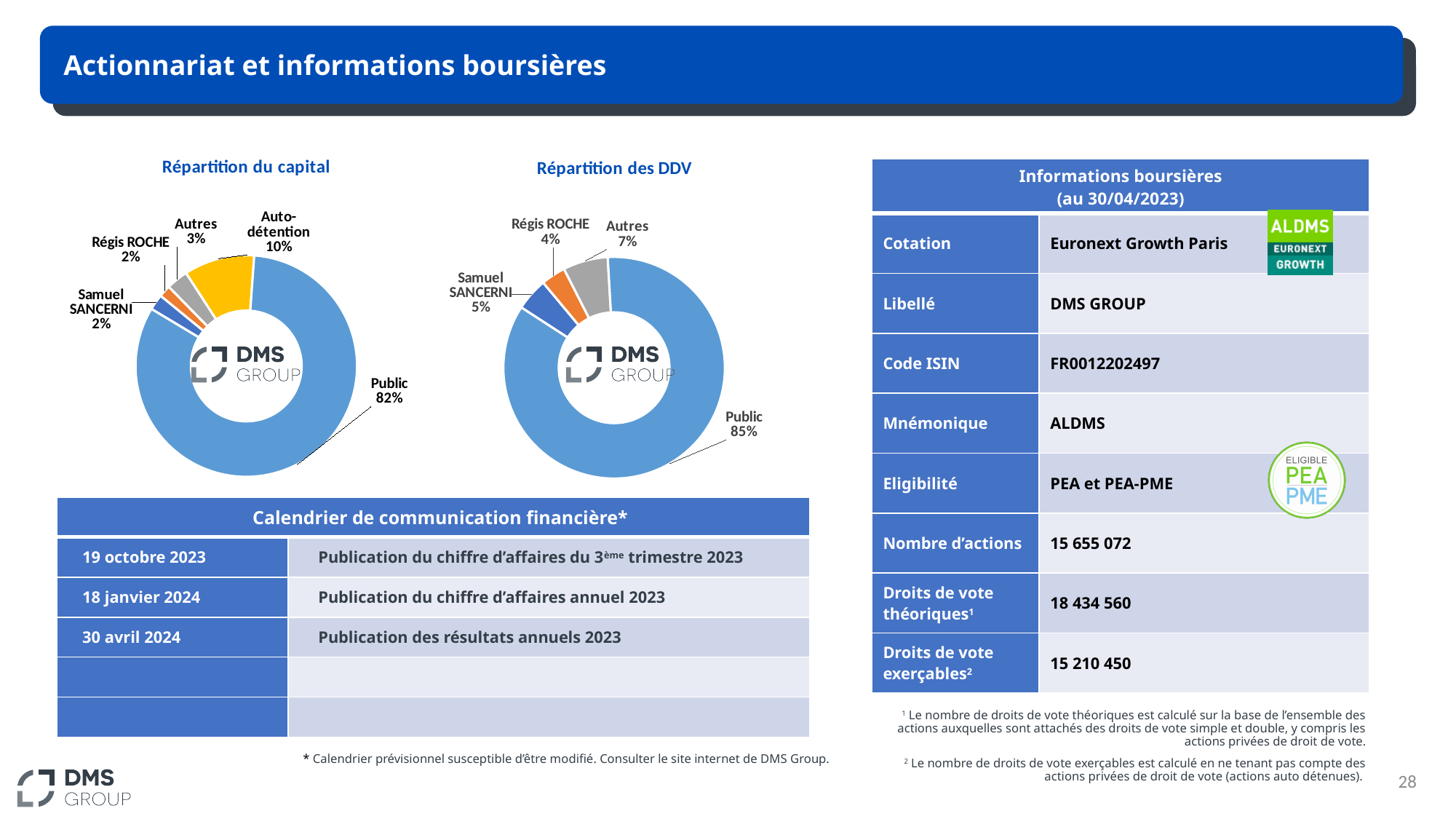
In the 'Répartition des DDV' chart, which category has the smallest share? Régis ROCHE In the 'Répartition du capital' chart, which category has the largest share? Public In the 'Répartition des DDV' chart, what share does Public hold? 85% In the 'Répartition du capital' chart, what share is Auto-détention? 10% What type of chart is 'Répartition des DDV'? Pie (donut) chart How many categories are shown in the 'Répartition du capital' chart? 5 In the 'Répartition des DDV' chart, what is the difference between the Public share and the Autres share? 78% In the 'Répartition des DDV' chart, what share is Autres? 7% In the 'Répartition des DDV' chart, what share does Samuel SANCERNI hold? 5% In the 'Répartition du capital' chart, which is larger: Auto-détention or Autres? Auto-détention In the 'Répartition du capital' chart, what share does Régis ROCHE hold? 2% In the 'Répartition du capital' chart, what share does Public hold? 82%